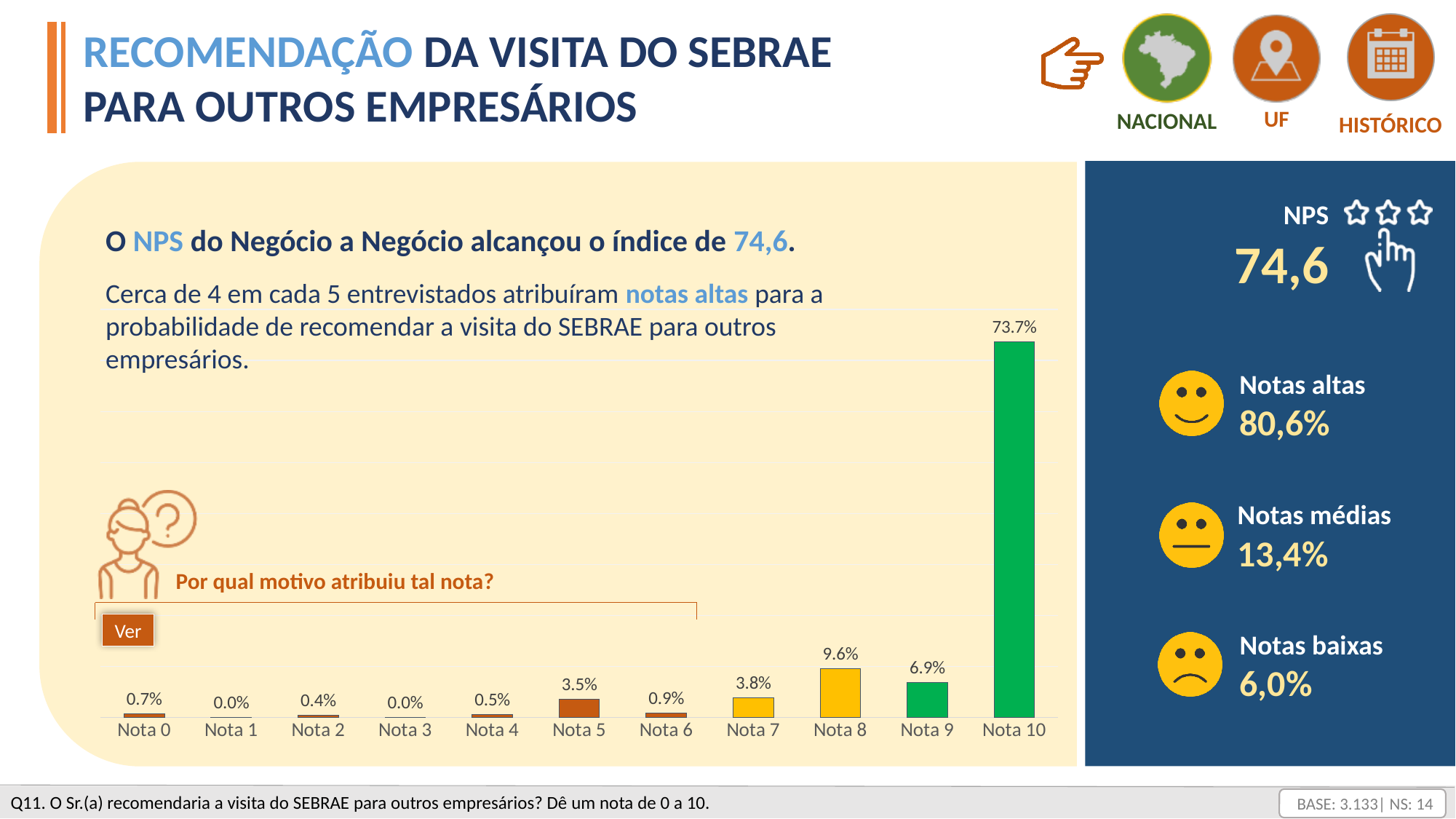
What is the value for Nota 8? 9.6% Which categories have a value of 0.0%? Nota 1 and Nota 3 What kind of chart is shown on the slide? Bar chart What is the difference between the values for Nota 10 and Nota 8? 64.1% What colour is the bar for Nota 10? Green What is the difference between the values for Nota 8 and Nota 9? 2.7% Which is larger, the value for Nota 7 or the value for Nota 5? Nota 7 What is the value for Nota 10? 73.7% What is the value for Nota 5? 3.5% What is the value for Nota 0? 0.7% Which category has the highest value? Nota 10 How many categories are shown on the x axis? 11